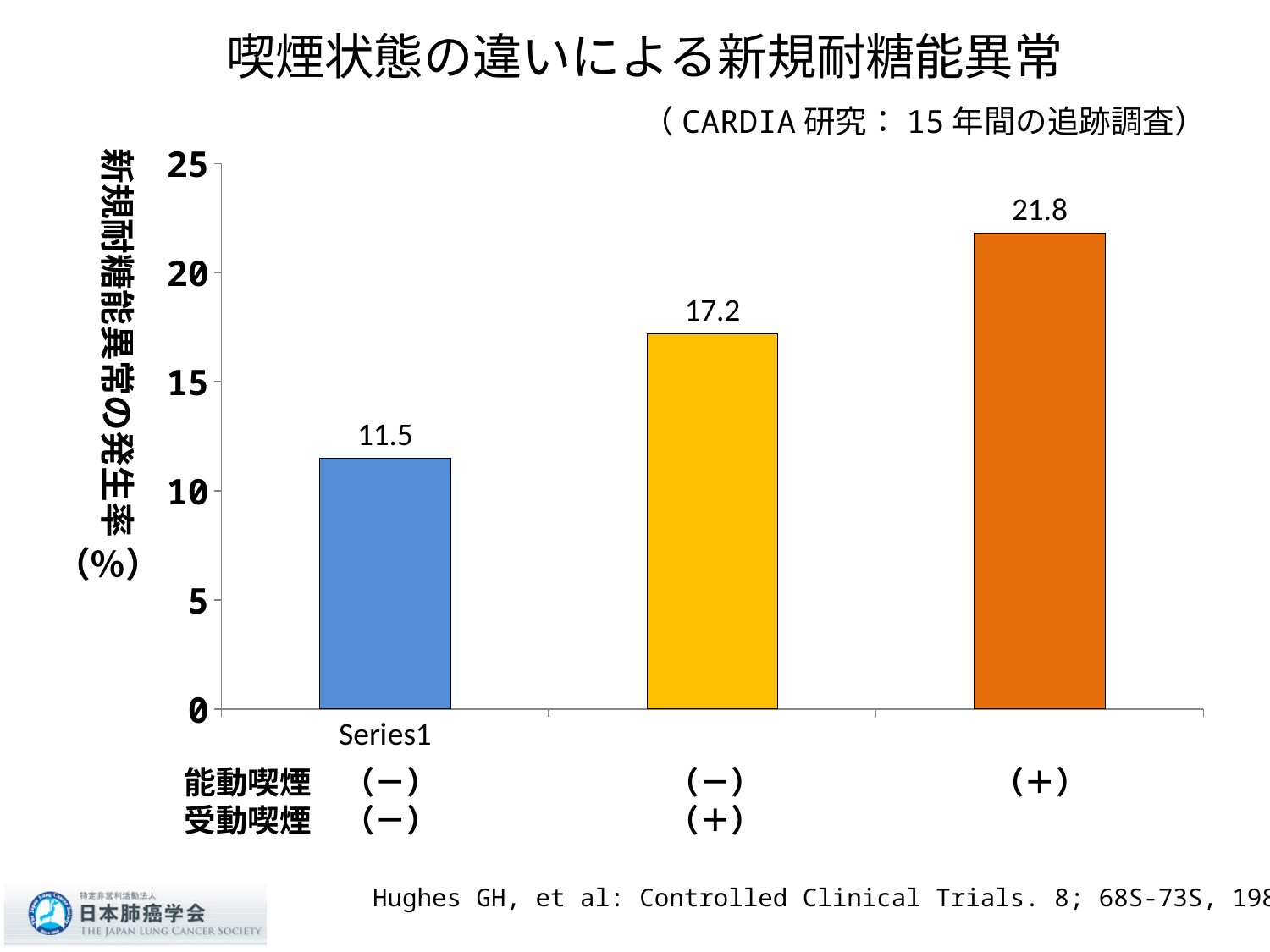
Do the values rise or fall from left to right across the bars? rise Is the value for the active smoking group greater or less than 20? greater What kind of chart is shown on the slide? bar chart What is the value for the group with no active smoking and no passive smoking (能動喫煙(−), 受動喫煙(−))? 11.5 What is the difference between the active smoking group (21.8) and the no active/no passive smoking group (11.5)? 10.3 Which is larger: the value for the passive smoking group (能動喫煙(−), 受動喫煙(+)) or the active smoking group (能動喫煙(+))? 能動喫煙(+) Which group has the highest rate of new glucose intolerance? 能動喫煙(+) What is the value for the group with no active smoking but passive smoking (能動喫煙(−), 受動喫煙(+))? 17.2 What is the value for the active smoking group (能動喫煙(+))? 21.8 What is the difference between the passive smoking group (17.2) and the no active/no passive smoking group (11.5)? 5.7 Which group has the lowest rate of new glucose intolerance? 能動喫煙(−), 受動喫煙(−) How many bars are shown in the chart? 3